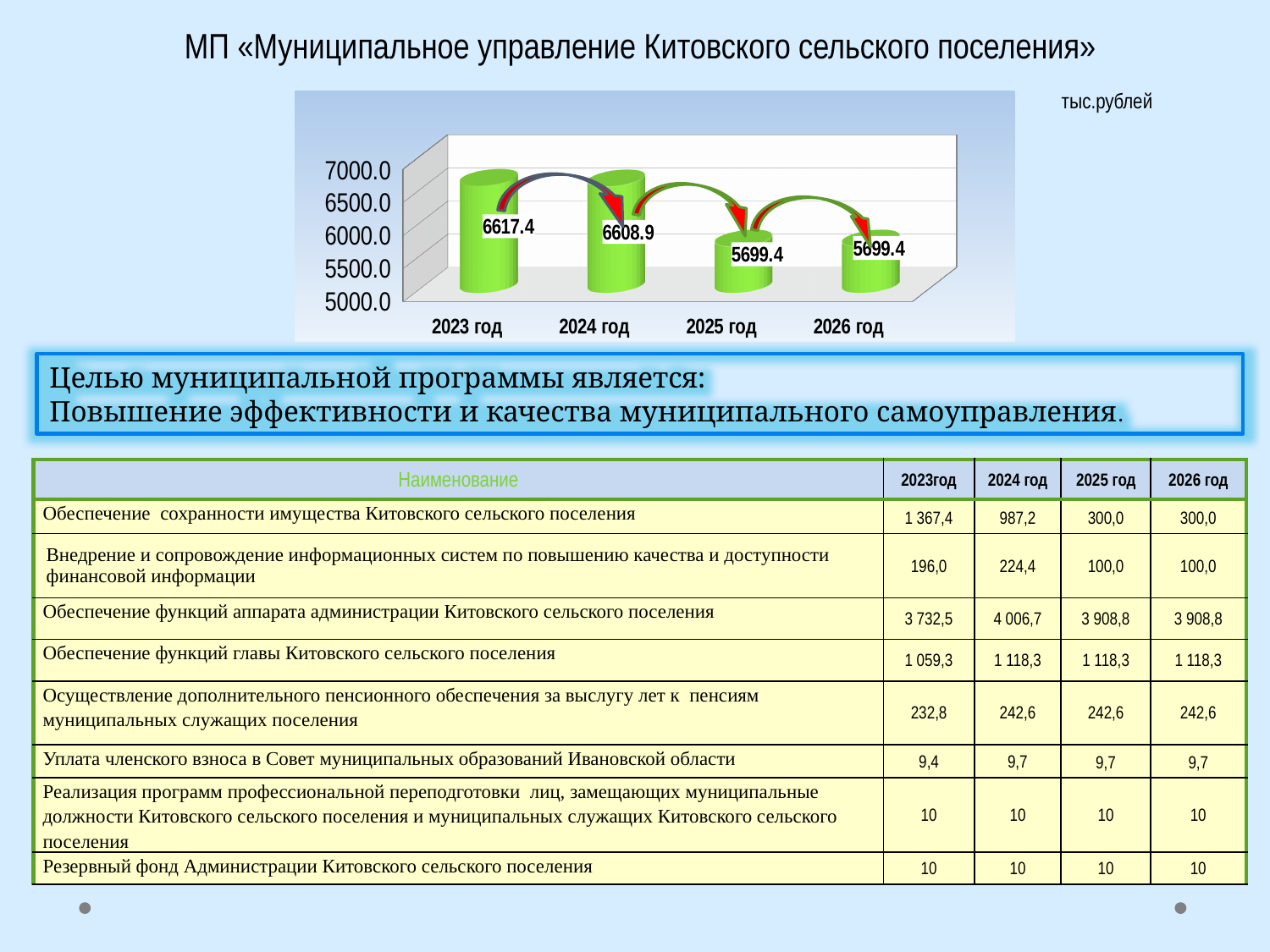
What kind of chart is shown on the slide? bar chart Do the values rise or fall from 2023 год to 2026 год? fall What is the difference between the values for 2024 год and 2025 год? 909.5 What is the value shown for 2023 год on the chart? 6617.4 Which year has the highest value on the chart? 2023 год What is the value shown for 2026 год on the chart? 5699.4 Is the value for 2025 год greater or less than 6000.0? less What is the difference between the values for 2023 год and 2024 год? 8.5 How many years are plotted on the chart? 4 Which is larger, the value for 2024 год or the value for 2026 год? 2024 год What is the value shown for 2024 год on the chart? 6608.9 What is the value shown for 2025 год on the chart? 5699.4